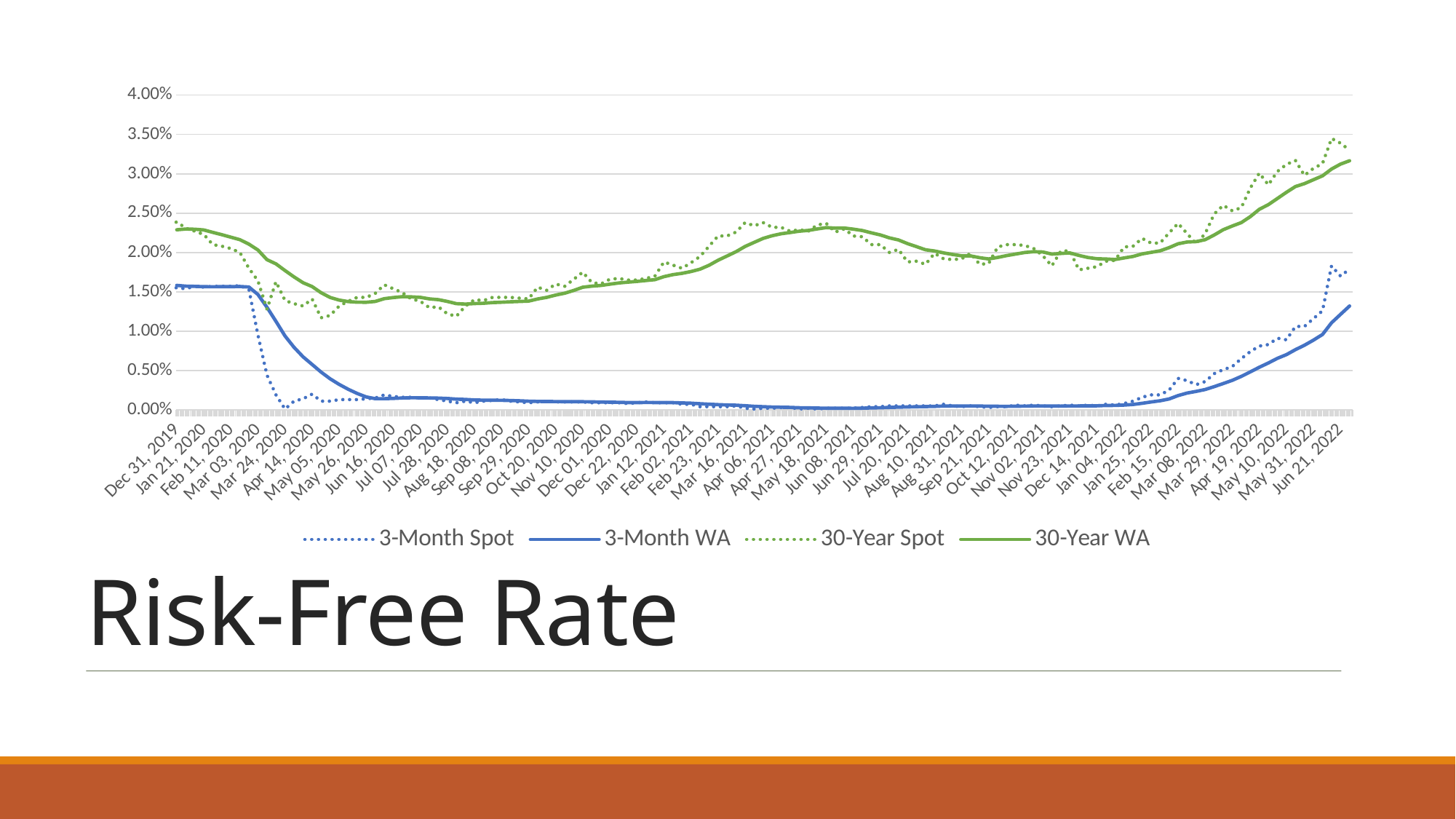
Is the value of 30-Year WA at Jun 21, 2022 greater or less than 3.00%? greater Does the 3-Month WA series rise or fall between Mar 03, 2020 and May 26, 2020? fall Is the value of 3-Month WA at Jun 08, 2021 greater or less than 0.50%? less Is the value of 3-Month WA at Jun 21, 2022 greater or less than 1.50%? less At Jun 21, 2022, which is higher: 30-Year WA or 3-Month WA? 30-Year WA What kind of chart is shown on the slide? line chart How many series does the legend list? 4 Does the 30-Year WA series rise or fall between Jan 04, 2022 and Jun 21, 2022? rise What is the title of the slide containing the chart? Risk-Free Rate Which series are shown with dotted lines in the legend? 3-Month Spot and 30-Year Spot